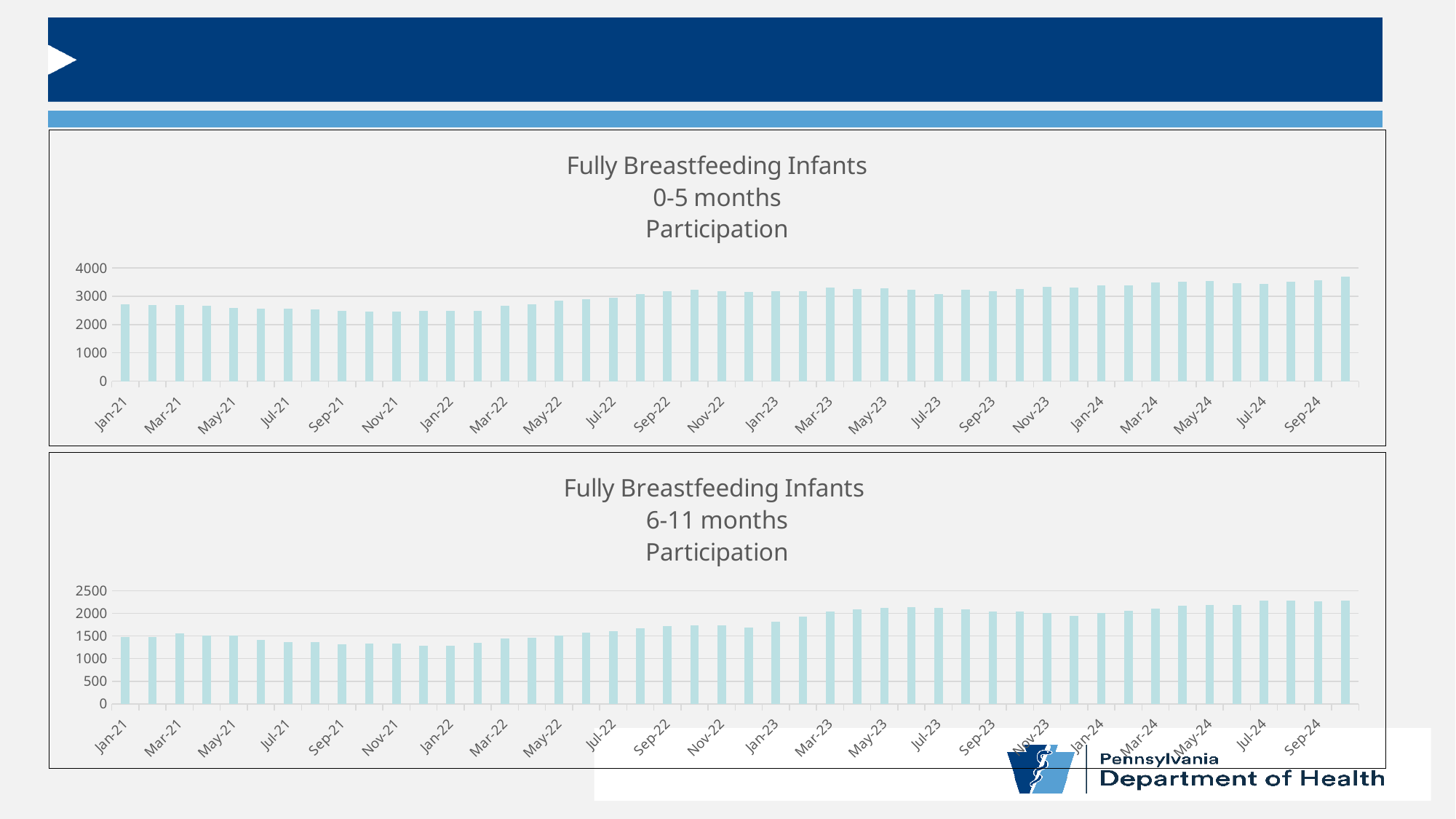
In the 'Fully Breastfeeding Infants 6-11 months Participation' chart, which is larger, the value for Jan-22 or the value for Jul-24? Jul-24 What is the title of the top chart on the slide? Fully Breastfeeding Infants 0-5 months Participation In the 'Fully Breastfeeding Infants 0-5 months Participation' chart, is the value for Jan-21 greater or less than 3000? less In the 'Fully Breastfeeding Infants 6-11 months Participation' chart, is the value for Jan-22 greater or less than 1500? less In the 'Fully Breastfeeding Infants 0-5 months Participation' chart, is the value for Sep-24 greater or less than 3000? greater In the 'Fully Breastfeeding Infants 6-11 months Participation' chart, do the values overall rise or fall from Jan-22 to Sep-24? rise What kind of chart is the 'Fully Breastfeeding Infants 0-5 months Participation' chart? bar chart In the 'Fully Breastfeeding Infants 0-5 months Participation' chart, which is larger, the value for Jan-21 or the value for Sep-24? Sep-24 What is the highest value shown on the vertical axis of the 'Fully Breastfeeding Infants 6-11 months Participation' chart? 2500 In the 'Fully Breastfeeding Infants 0-5 months Participation' chart, do the values overall rise or fall from Jan-22 to Sep-24? rise